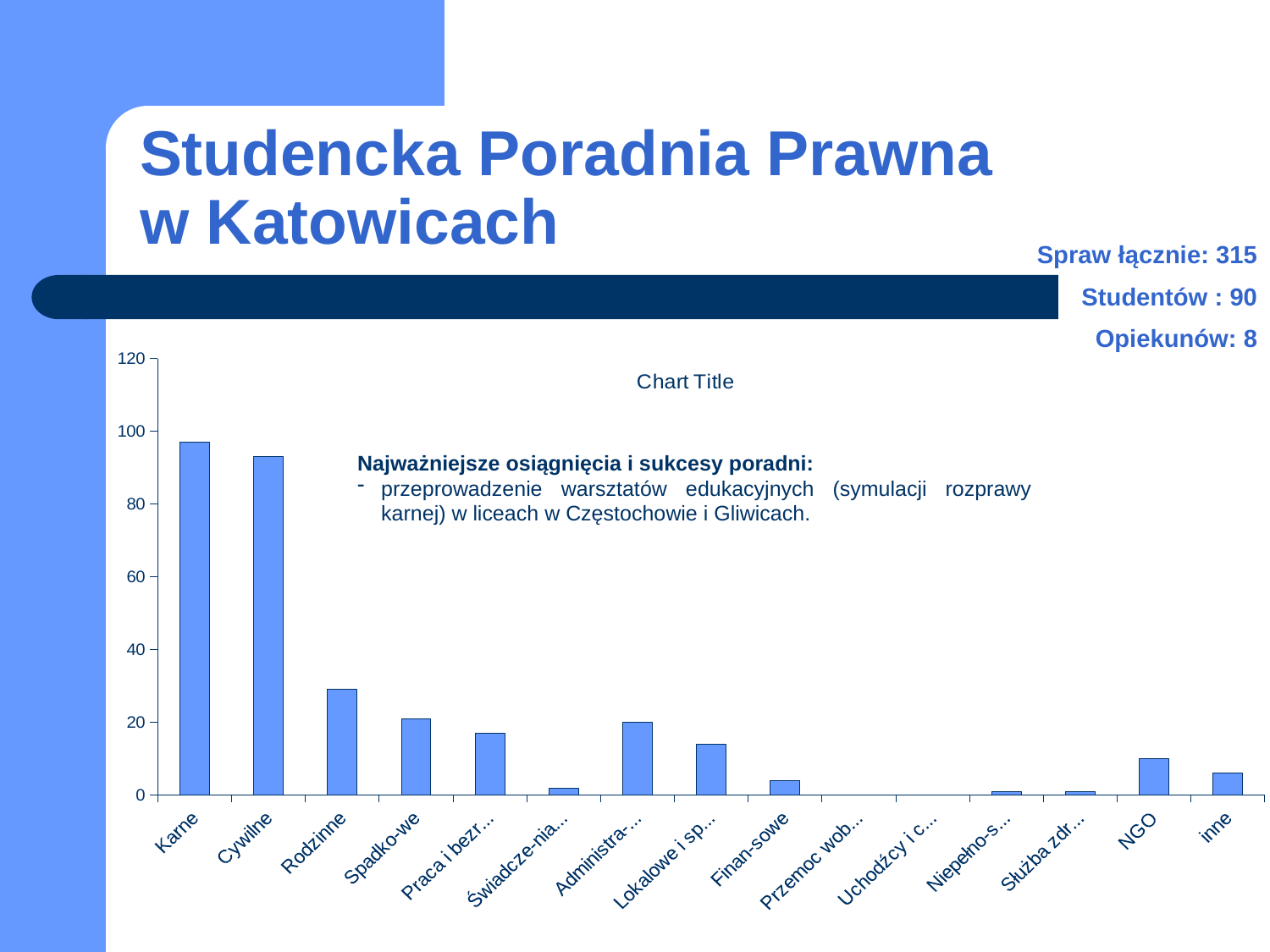
Which is larger, the value for NGO or the value for inne? NGO What is the title shown on the chart? Chart Title Is the value for Spadko-we greater or less than 40? less Is the value for Karne greater or less than 80? greater Which is larger, the value for Rodzinne or the value for Spadko-we? Rodzinne Is the value for Rodzinne greater or less than 20? greater Which is larger, the value for Karne or the value for Cywilne? Karne How many categories are shown on the x axis of the chart? 15 Which category has the highest bar in the chart? Karne What kind of chart is shown on the slide? bar chart